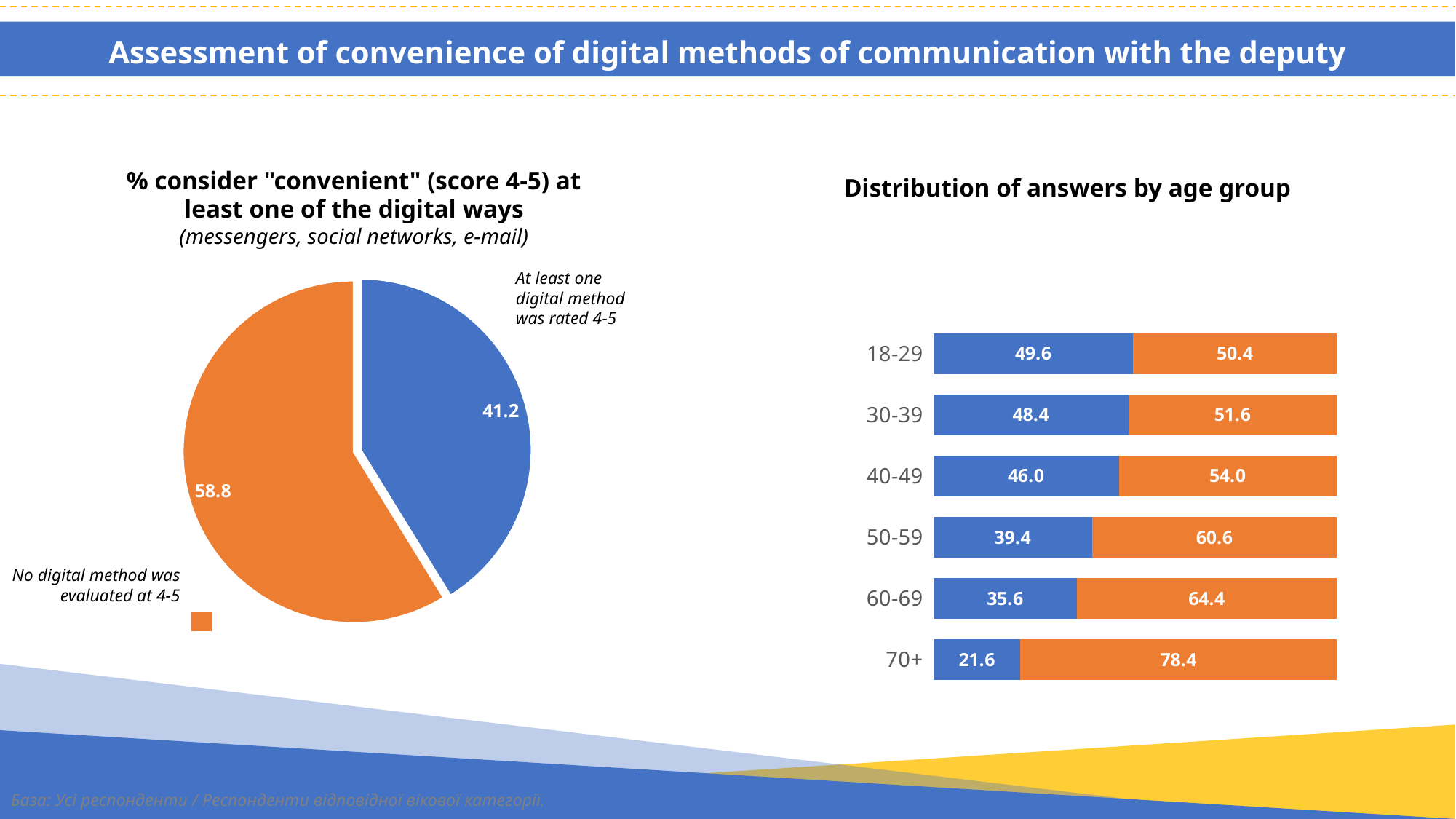
In 'Distribution of answers by age group', what is the difference between the orange values for 70+ and 18-29? 28.0 What kind of chart is the chart on the left? Pie chart In 'Distribution of answers by age group', what is the orange value for the 70+ age group? 78.4 In 'Distribution of answers by age group', which age group has the highest blue value? 18-29 In 'Distribution of answers by age group', which age group has the lowest blue value? 70+ In the pie chart on the left, what share of respondents rated at least one digital method 4-5? 41.2 In 'Distribution of answers by age group', do the blue values rise or fall as the age groups get older? Fall In the pie chart on the left, which slice is larger: 'At least one digital method was rated 4-5' or 'No digital method was evaluated at 4-5'? No digital method was evaluated at 4-5 What kind of chart is 'Distribution of answers by age group'? Bar chart In 'Distribution of answers by age group', what is the blue value for the 40-49 age group? 46.0 How many age groups are shown in 'Distribution of answers by age group'? 6 In the pie chart on the left, what is the value for 'No digital method was evaluated at 4-5'? 58.8